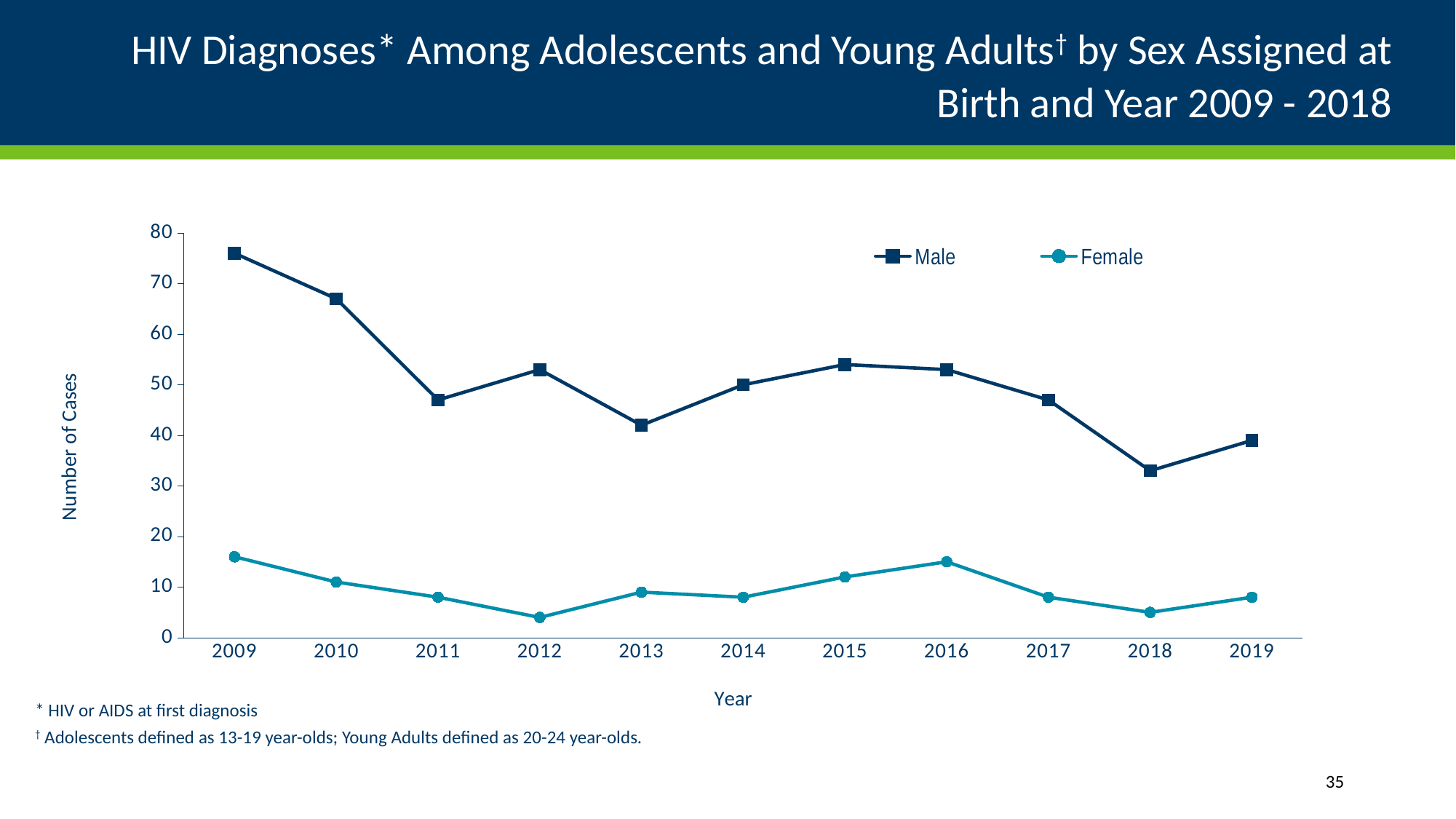
Is the Male value for 2009 greater or less than 70? greater In which year is the Female series at its lowest? 2012 Is the Female value for 2016 greater or less than 10? greater What kind of chart is shown on the slide? line chart Is the Male value for 2018 greater or less than 40? less How many series does the legend list? 2 In which year is the Male series at its lowest? 2018 In which year is the Female series at its highest? 2009 What is the label on the y axis? Number of Cases How many years are plotted along the x axis? 11 In which year is the Male series at its highest? 2009 Which series has the larger value in 2015, Male or Female? Male